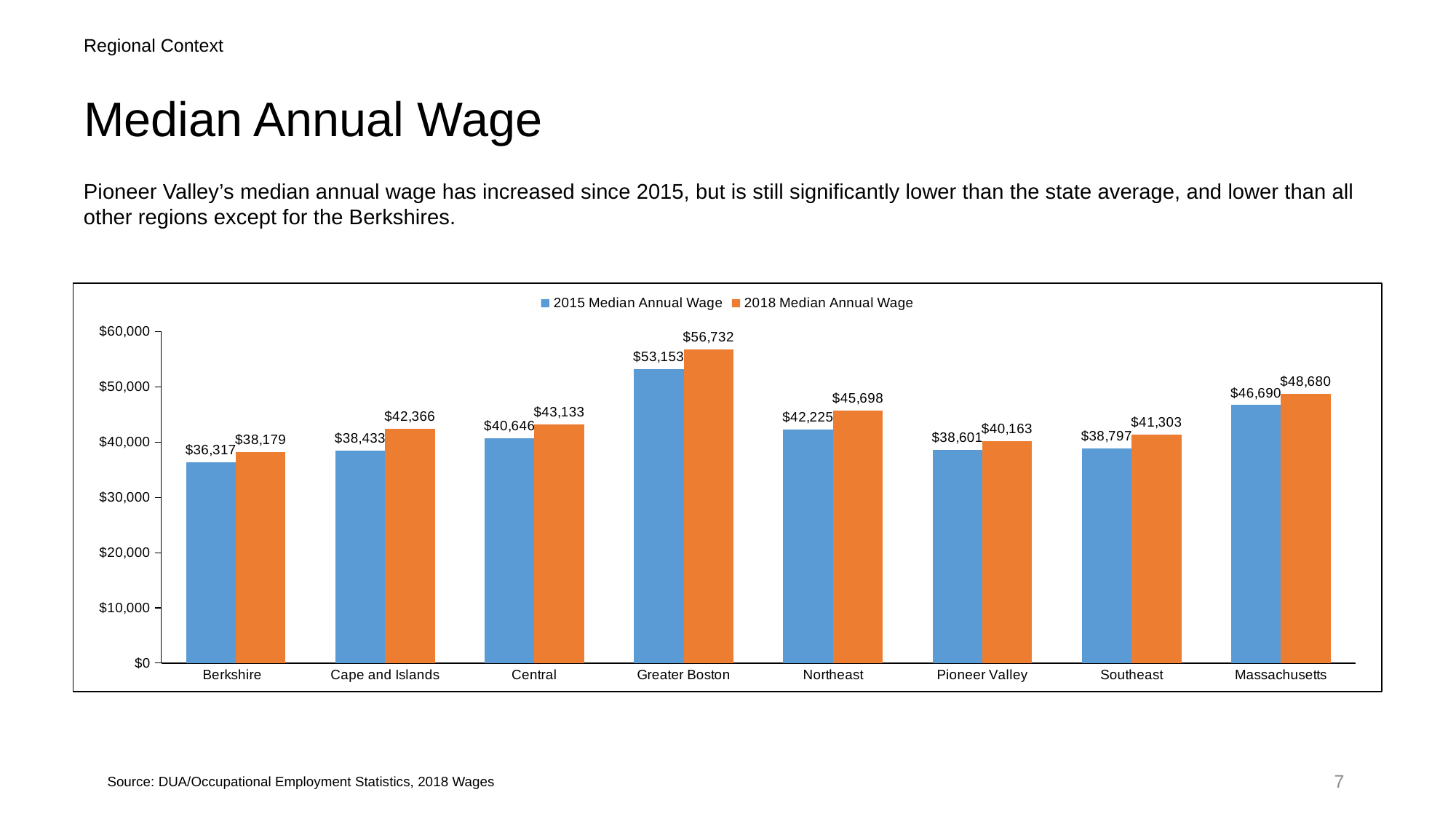
Which region had the highest 2018 Median Annual Wage? Greater Boston What was the 2018 Median Annual Wage for Pioneer Valley? $40,163 Which had a higher 2018 Median Annual Wage, Cape and Islands or Southeast? Cape and Islands What was the 2018 Median Annual Wage for Massachusetts? $48,680 Which region had the lowest 2015 Median Annual Wage? Berkshire By how much did Pioneer Valley's median annual wage increase from 2015 to 2018? $1,562 What is the difference between the 2018 Median Annual Wage for Massachusetts and for Pioneer Valley? $8,517 Is the 2015 Median Annual Wage for Northeast greater or less than $40,000? greater What type of chart is shown on the slide? Bar chart How many series does the chart legend list? 2 What was the 2015 Median Annual Wage for Greater Boston? $53,153 How many regions are shown on the x axis of the chart? 8